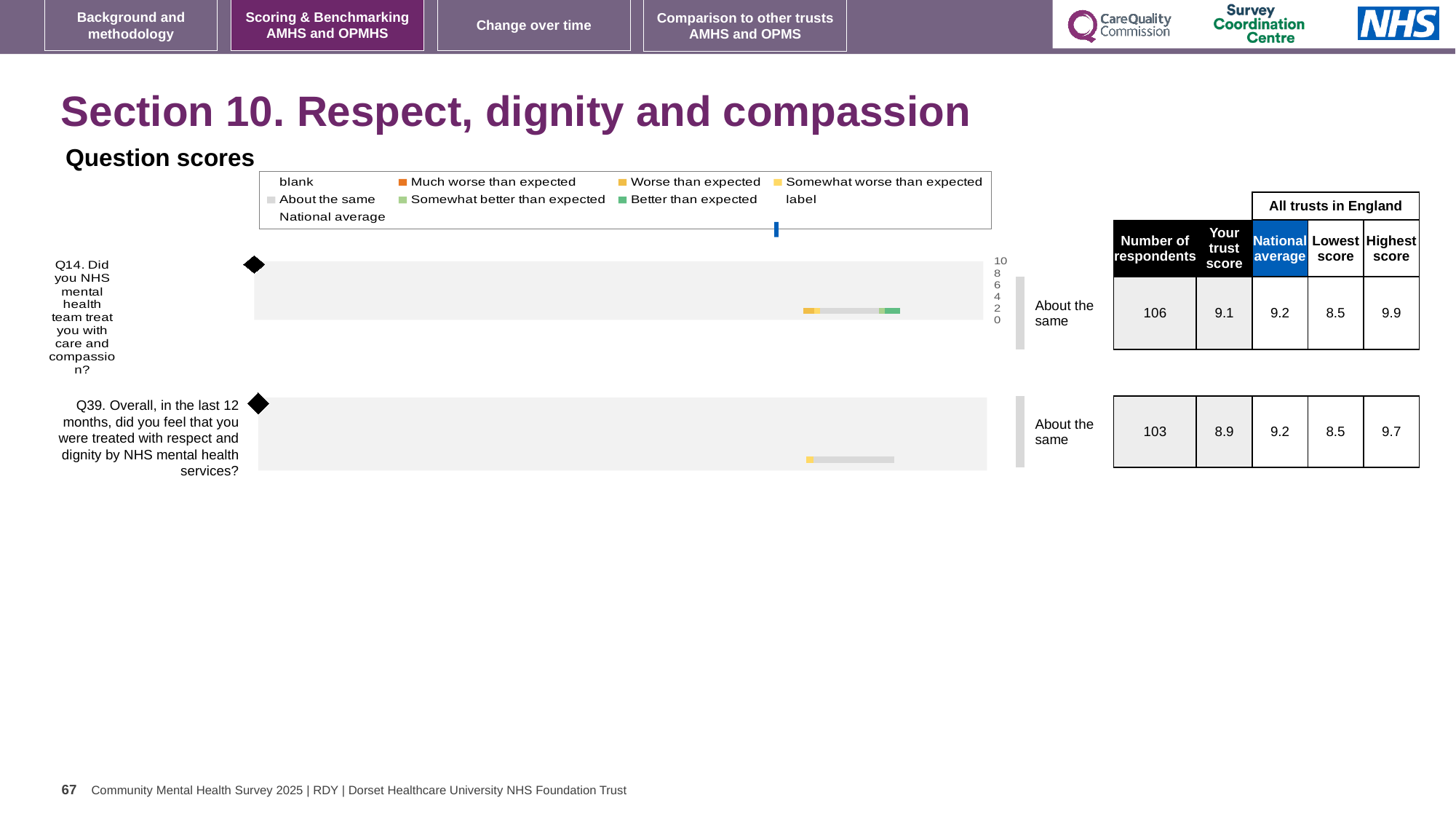
What is the highest score among all trusts in England for Q14? 9.9 What is the national average for Q14? 9.2 How many questions are plotted in the question scores chart? 2 What kind of chart is used to show the question scores on this slide? bar chart What is the difference between the trust score and the national average for Q39? 0.3 Which legend entry is shown in dark green? Better than expected How many respondents answered Q39? 103 Which question has the higher trust score, Q14 or Q39? Q14 What is the trust score for Q14 (care and compassion)? 9.1 What is the lowest score among all trusts in England for Q39? 8.5 What benchmark category is shown next to the bar for Q14? About the same What is the trust score for Q39 (respect and dignity)? 8.9